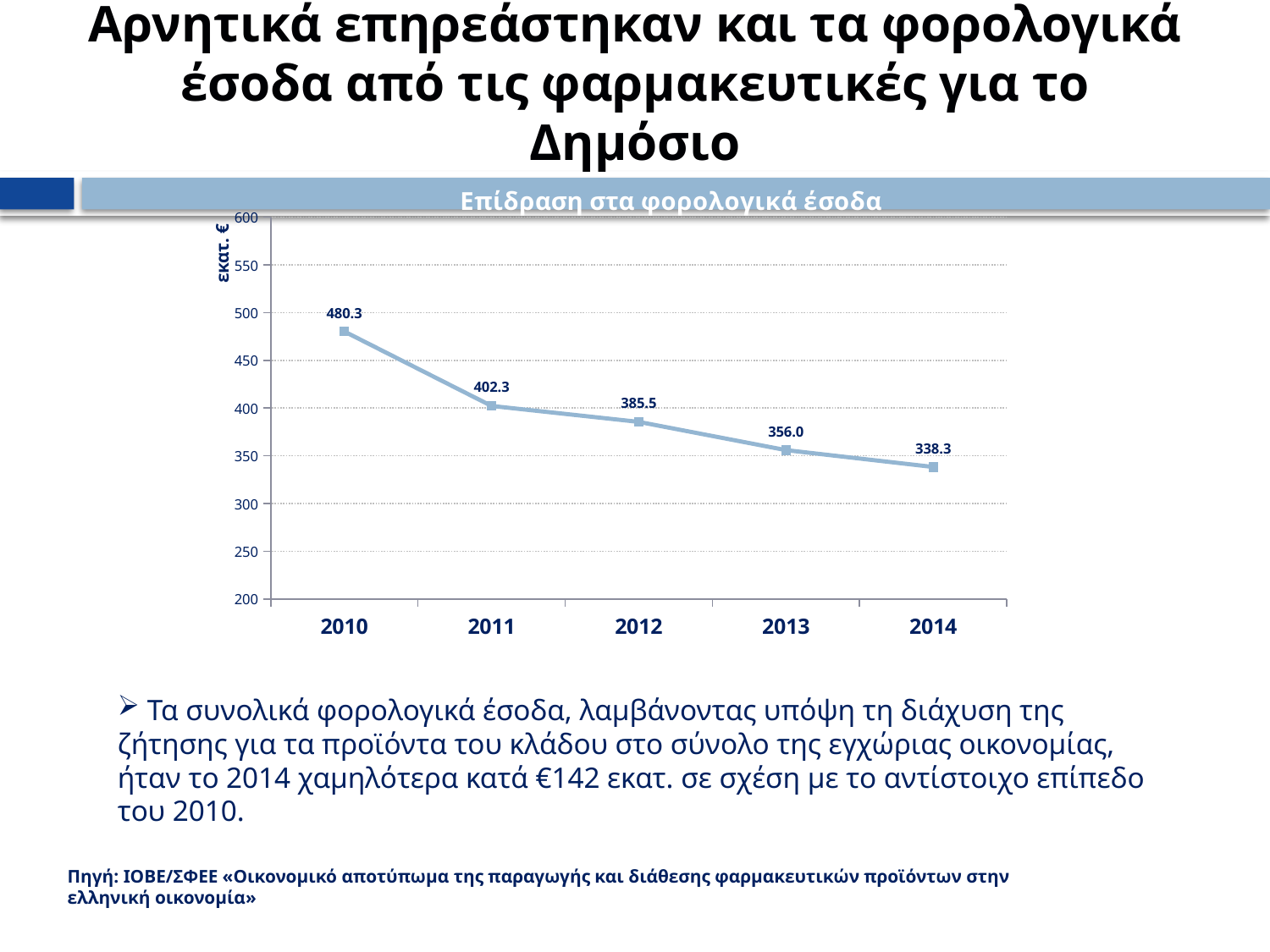
Which year has the lowest value? 2014 Is the value for 2013 greater or less than 400? less What kind of chart is shown? line chart How many years are plotted on the chart? 5 What is the value for 2012? 385.5 What is the value for 2010? 480.3 Which is larger, the value for 2011 or the value for 2013? 2011 Do the values rise or fall from 2010 to 2014? fall What is the difference between the values for 2011 and 2013? 46.3 What is the value for 2014? 338.3 Which year has the highest value? 2010 What is the difference between the values for 2010 and 2014? 142.0